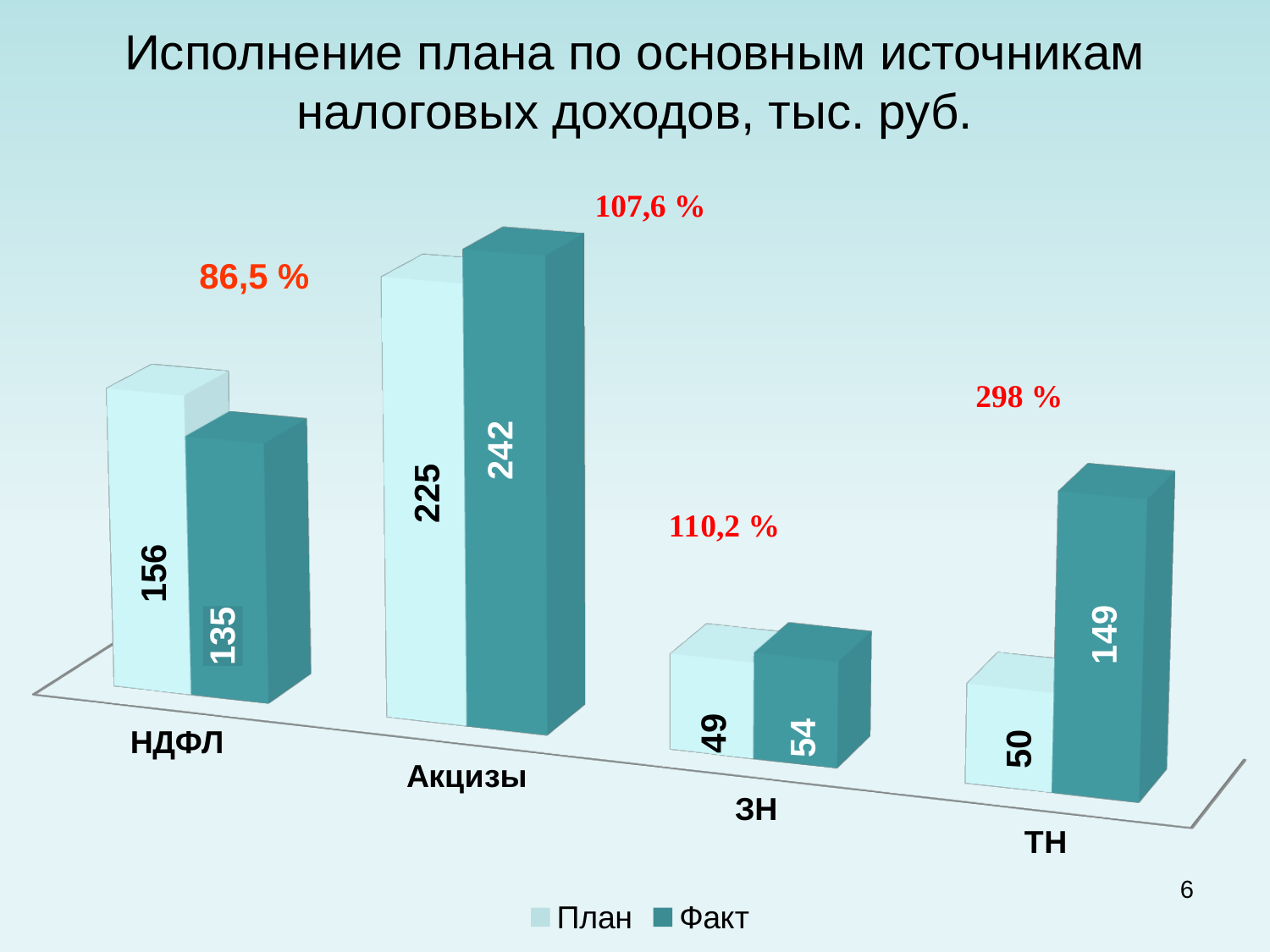
What percentage is shown above the ТН bars? 298 % What is the План value for НДФЛ? 156 For НДФЛ, which is larger: План or Факт? План How many series does the legend list? 2 What is the Факт value for ТН? 149 What is the План value for ЗН? 49 Which category has the lowest План value? ЗН What is the difference between the Факт and План values for ТН? 99 What is the Факт value for Акцизы? 242 What kind of chart is shown on the slide? Bar chart Which category has the highest Факт value? Акцизы How many categories are shown on the x axis? 4